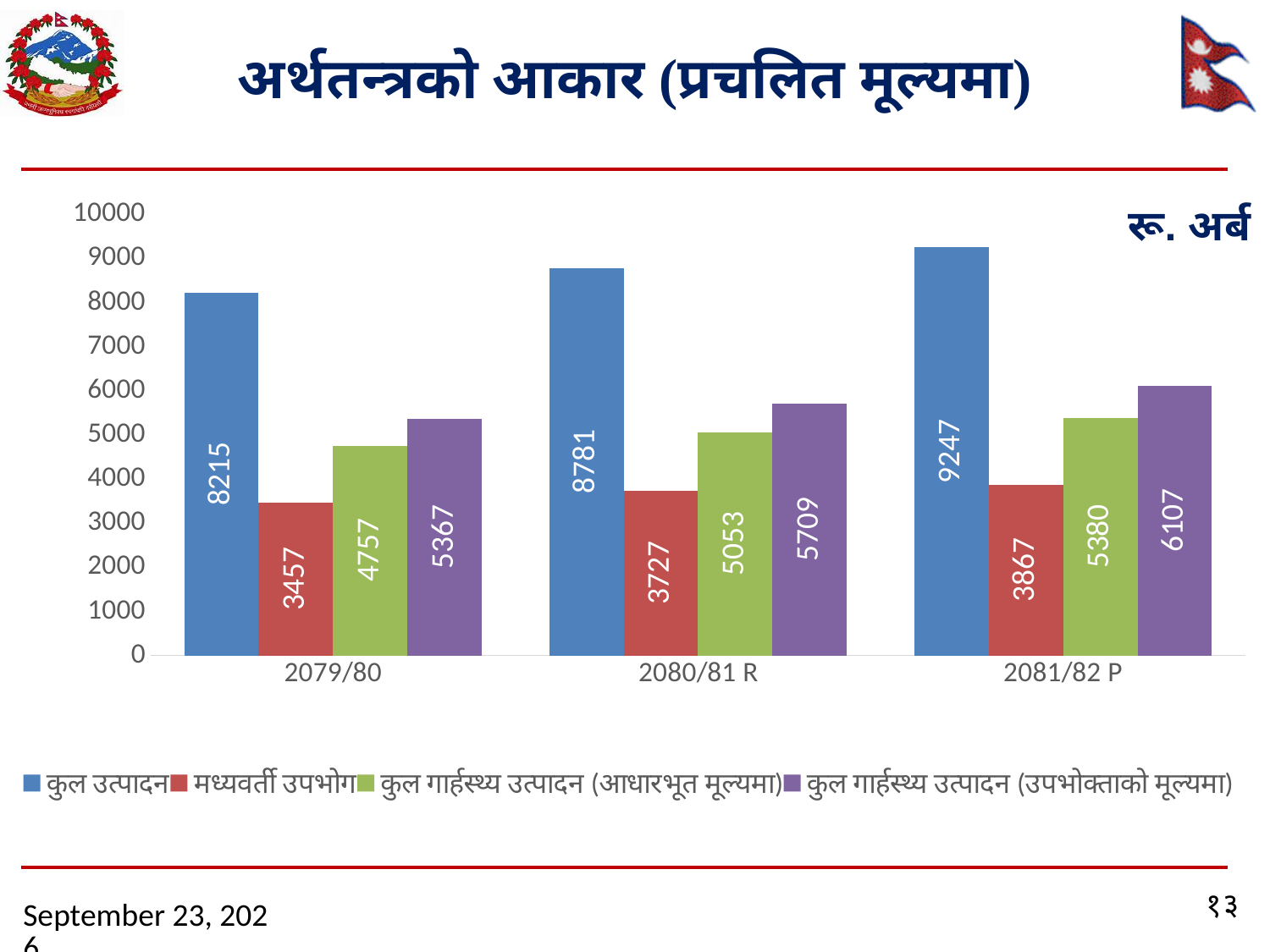
What is the difference between कुल उत्पादन in 2081/82 P and in 2079/80? 1032 Which is larger: कुल गार्हस्थ्य उत्पादन (उपभोक्ताको मूल्यमा) in 2079/80 or कुल गार्हस्थ्य उत्पादन (आधारभूत मूल्यमा) in 2080/81 R? कुल गार्हस्थ्य उत्पादन (उपभोक्ताको मूल्यमा) in 2079/80 What is the value of कुल गार्हस्थ्य उत्पादन (उपभोक्ताको मूल्यमा) for 2080/81 R? 5709 In which year is कुल उत्पादन highest? 2081/82 P Does कुल उत्पादन rise or fall from 2079/80 to 2081/82 P? Rise How many year categories are shown on the x axis? 3 What kind of chart is shown on the slide? Bar chart What is the value of मध्यवर्ती उपभोग for 2081/82 P? 3867 What is the value of कुल उत्पादन for 2079/80? 8215 What is the value of कुल गार्हस्थ्य उत्पादन (आधारभूत मूल्यमा) for 2081/82 P? 5380 In which year is मध्यवर्ती उपभोग lowest? 2079/80 How many series does the legend list? 4